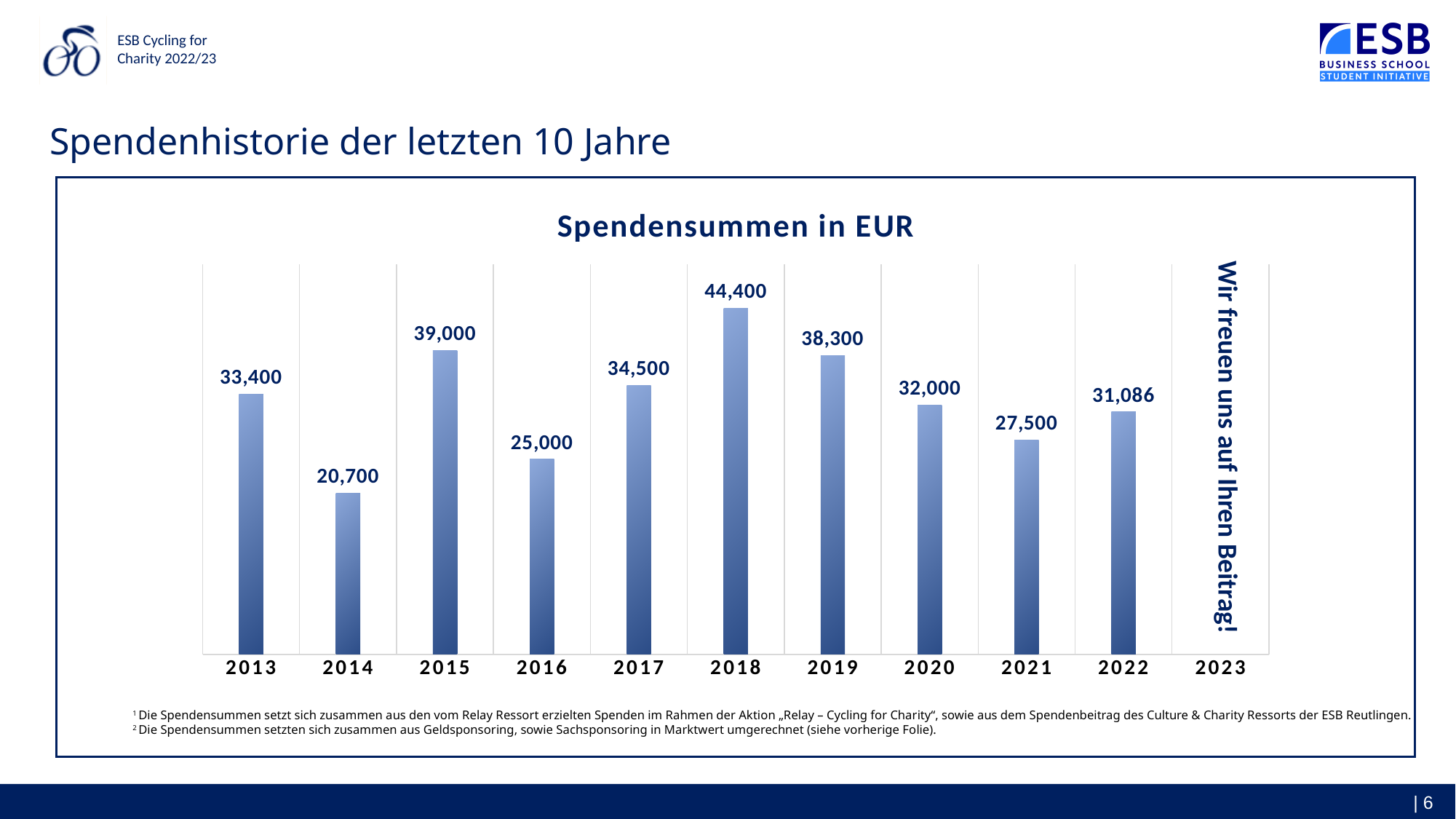
How many years have a bar plotted in the chart? 10 What is the donation sum for 2022? 31,086 What is the title of the chart? Spendensummen in EUR What is the difference between the donation sums for 2015 and 2016? 14,000 What kind of chart is shown on the slide? Bar chart What is the donation sum for 2018? 44,400 Do the donation sums rise or fall from 2019 to 2021? Fall Which year has the highest donation sum? 2018 Which year has the lowest donation sum? 2014 What is the difference between the donation sums for 2018 and 2019? 6,100 What is the donation sum for 2014? 20,700 Which year has a larger donation sum, 2017 or 2020? 2017